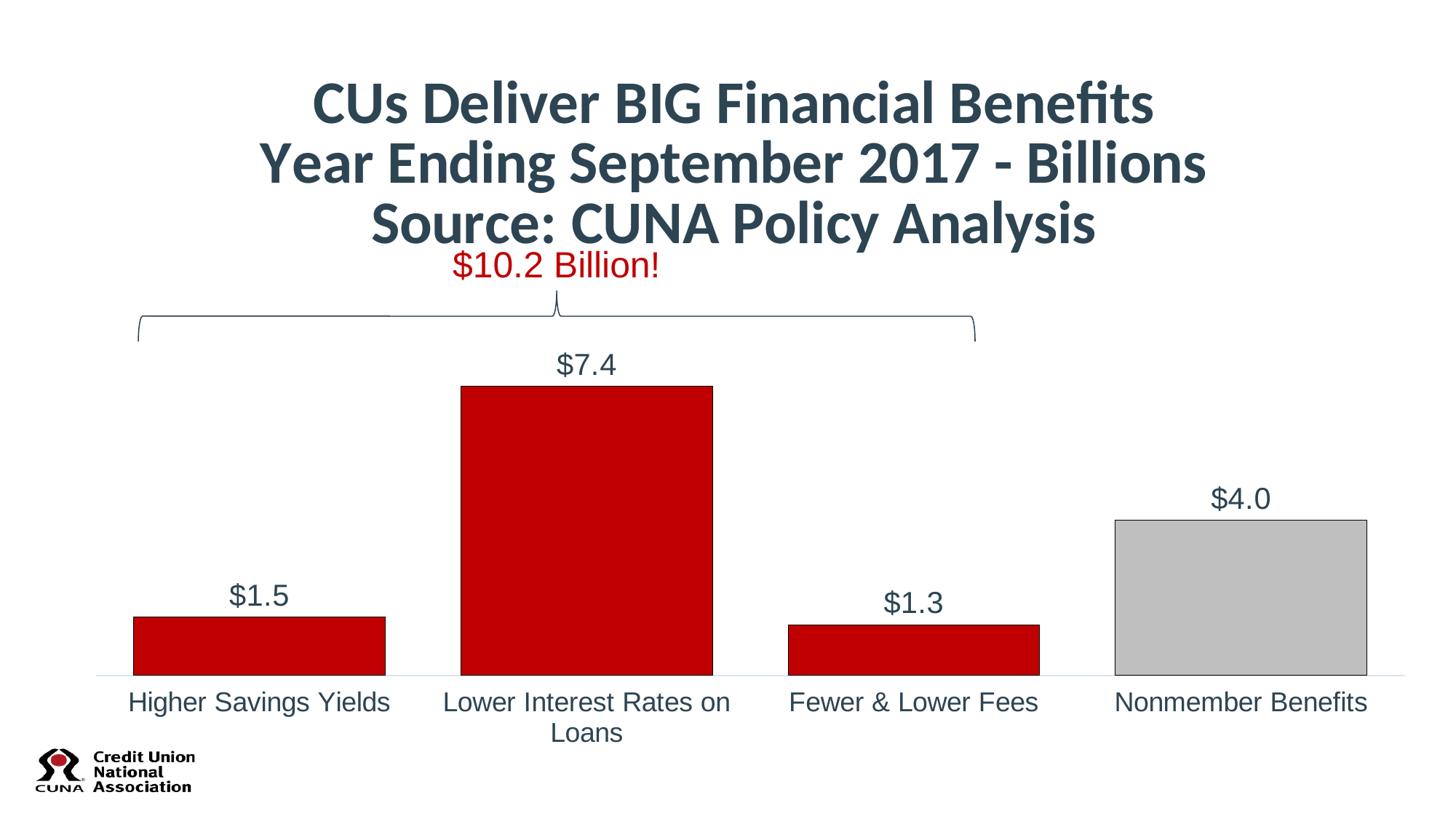
What is the value for Nonmember Benefits? $4.0 Which category has the highest value? Lower Interest Rates on Loans What kind of chart is shown on the slide? Bar chart What is the difference between the values for Higher Savings Yields and Fewer & Lower Fees? $0.2 Which is larger, the value for Nonmember Benefits or the value for Higher Savings Yields? Nonmember Benefits How many categories are shown in the chart? 4 What is the value for Higher Savings Yields? $1.5 What is the difference between the values for Lower Interest Rates on Loans and Nonmember Benefits? $3.4 What is the value for Fewer & Lower Fees? $1.3 Which category has the lowest value? Fewer & Lower Fees What total is shown by the bracket above the first three bars? $10.2 Billion! What is the value for Lower Interest Rates on Loans? $7.4